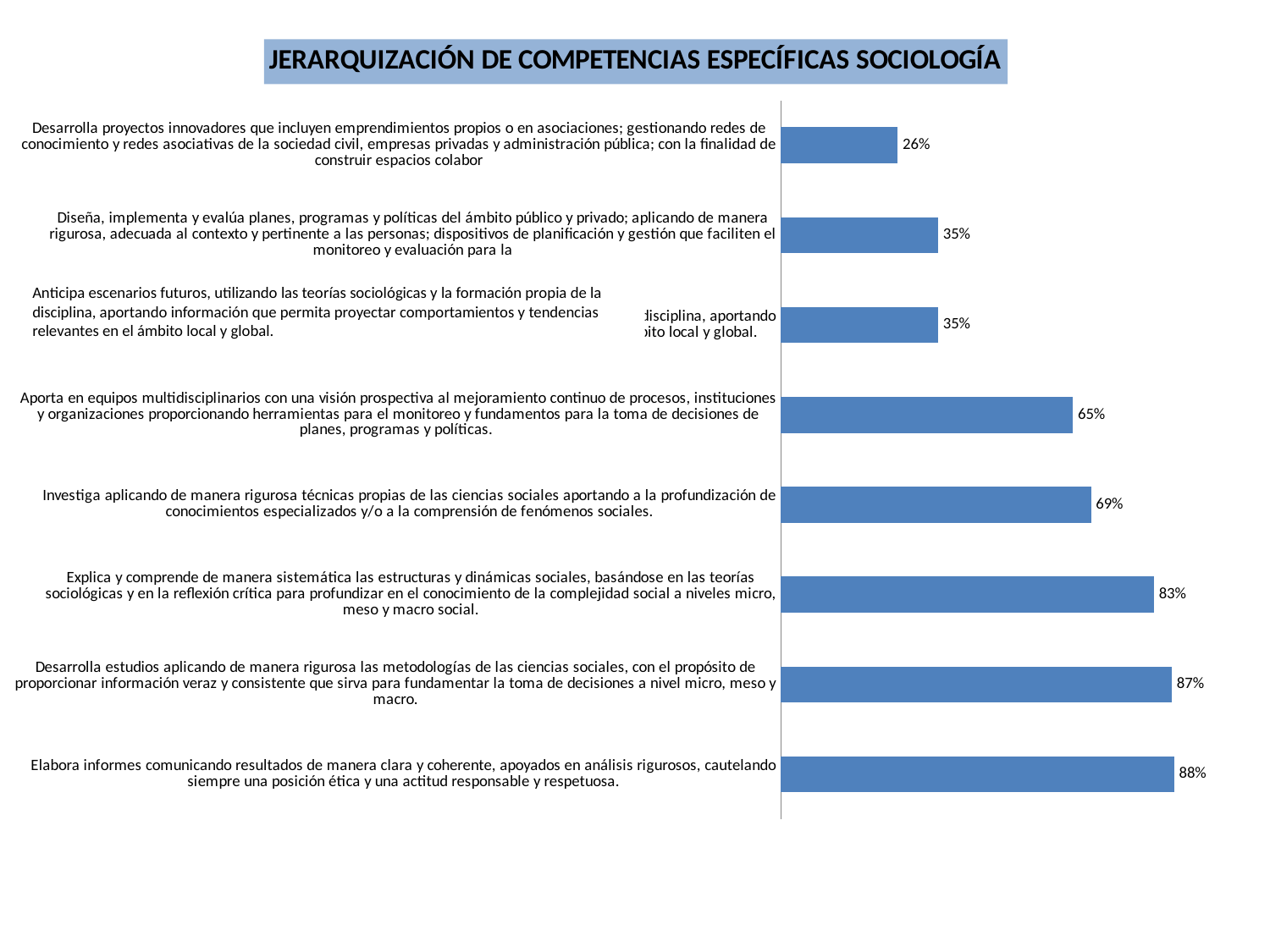
What type of chart is shown on the slide? bar chart Which has a larger value: "Investiga aplicando de manera rigurosa técnicas propias de las ciencias sociales..." or "Diseña, implementa y evalúa planes, programas y políticas del ámbito público y privado..."? Investiga aplicando de manera rigurosa técnicas propias de las ciencias sociales... What is the value for the competency "Elabora informes comunicando resultados de manera clara y coherente..."? 88% How many competencies (bars) are shown in the chart? 8 What is the difference between the value for "Desarrolla estudios aplicando de manera rigurosa las metodologías de las ciencias sociales..." and the value for "Explica y comprende de manera sistemática las estructuras y dinámicas sociales..."? 4% What is the value for the competency "Investiga aplicando de manera rigurosa técnicas propias de las ciencias sociales..."? 69% What is the difference between the highest value (88%) and the lowest value (26%) in the chart? 62% Which competency has the highest value? Elabora informes comunicando resultados de manera clara y coherente, apoyados en análisis rigurosos, cautelando siempre una posición ética y una actitud responsable y respetuosa. What is the value for the competency "Desarrolla proyectos innovadores que incluyen emprendimientos propios o en asociaciones..."? 26% What is the title of the chart? JERARQUIZACIÓN DE COMPETENCIAS ESPECÍFICAS SOCIOLOGÍA What is the value for the competency "Aporta en equipos multidisciplinarios con una visión prospectiva..."? 65%